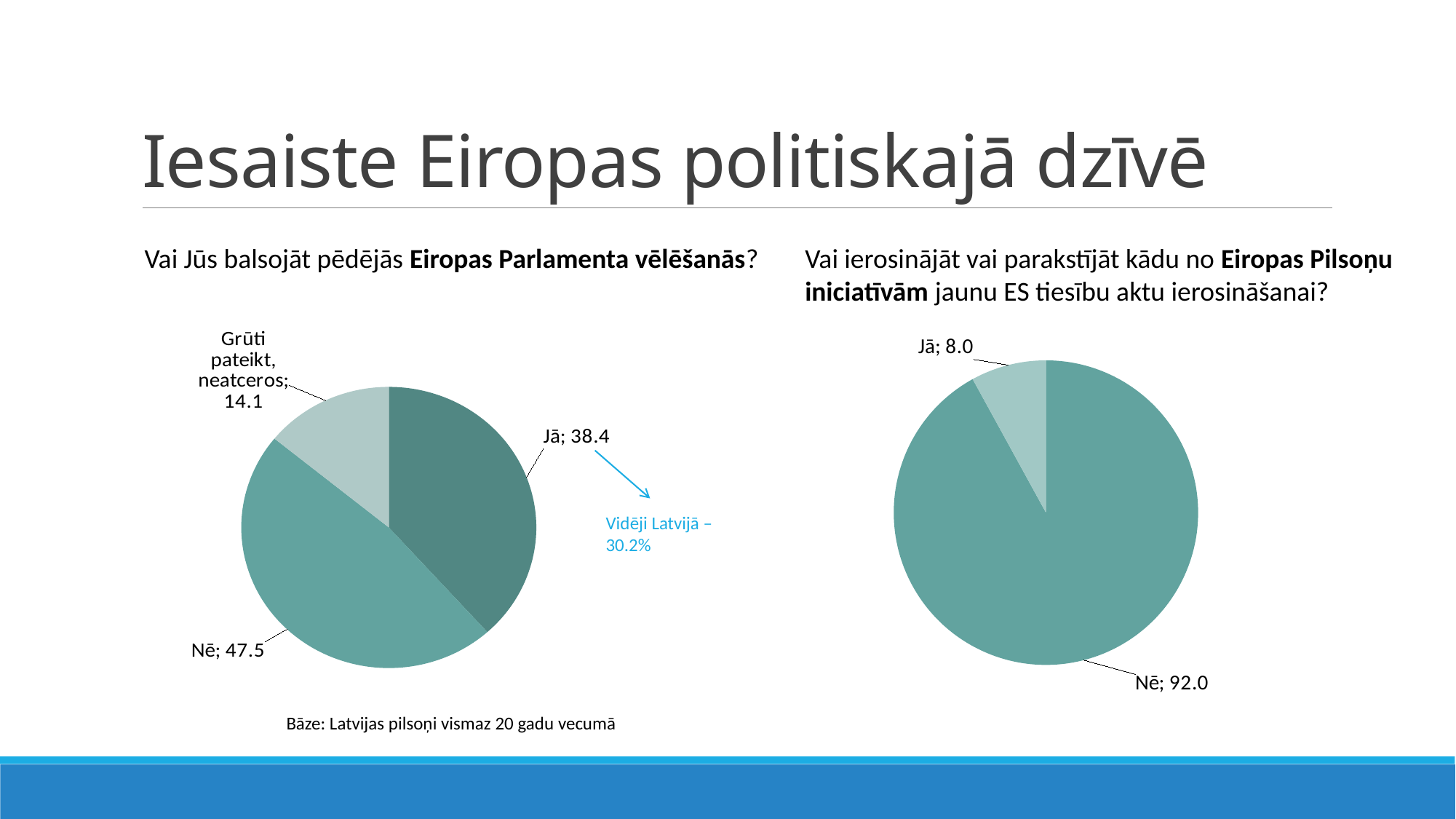
In the left pie chart (Eiropas Parlamenta vēlēšanās), what is the difference between the "Nē" and "Jā" values? 9.1 What kind of chart is used on the right side of the slide (Eiropas Pilsoņu iniciatīvām)? Pie chart In the left pie chart (Eiropas Parlamenta vēlēšanās), what is the value for "Jā"? 38.4 In the left pie chart (Eiropas Parlamenta vēlēšanās), what is the value for "Grūti pateikt, neatceros"? 14.1 In the left pie chart (Eiropas Parlamenta vēlēšanās), which category has the smallest slice? Grūti pateikt, neatceros In the left pie chart (Eiropas Parlamenta vēlēšanās), which category has the largest slice? Nē In the right pie chart (Eiropas Pilsoņu iniciatīvām), what is the value for "Jā"? 8.0 In the left pie chart (Eiropas Parlamenta vēlēšanās), what average value for Latvia (Vidēji Latvijā) is annotated next to the "Jā" slice? 30.2% In the right pie chart (Eiropas Pilsoņu iniciatīvām), what is the value for "Nē"? 92.0 In the left pie chart (Eiropas Parlamenta vēlēšanās), what is the value for "Nē"? 47.5 In the left pie chart (Eiropas Parlamenta vēlēšanās), how many slices does the pie have? 3 In the right pie chart (Eiropas Pilsoņu iniciatīvām), which is larger, "Jā" or "Nē"? Nē